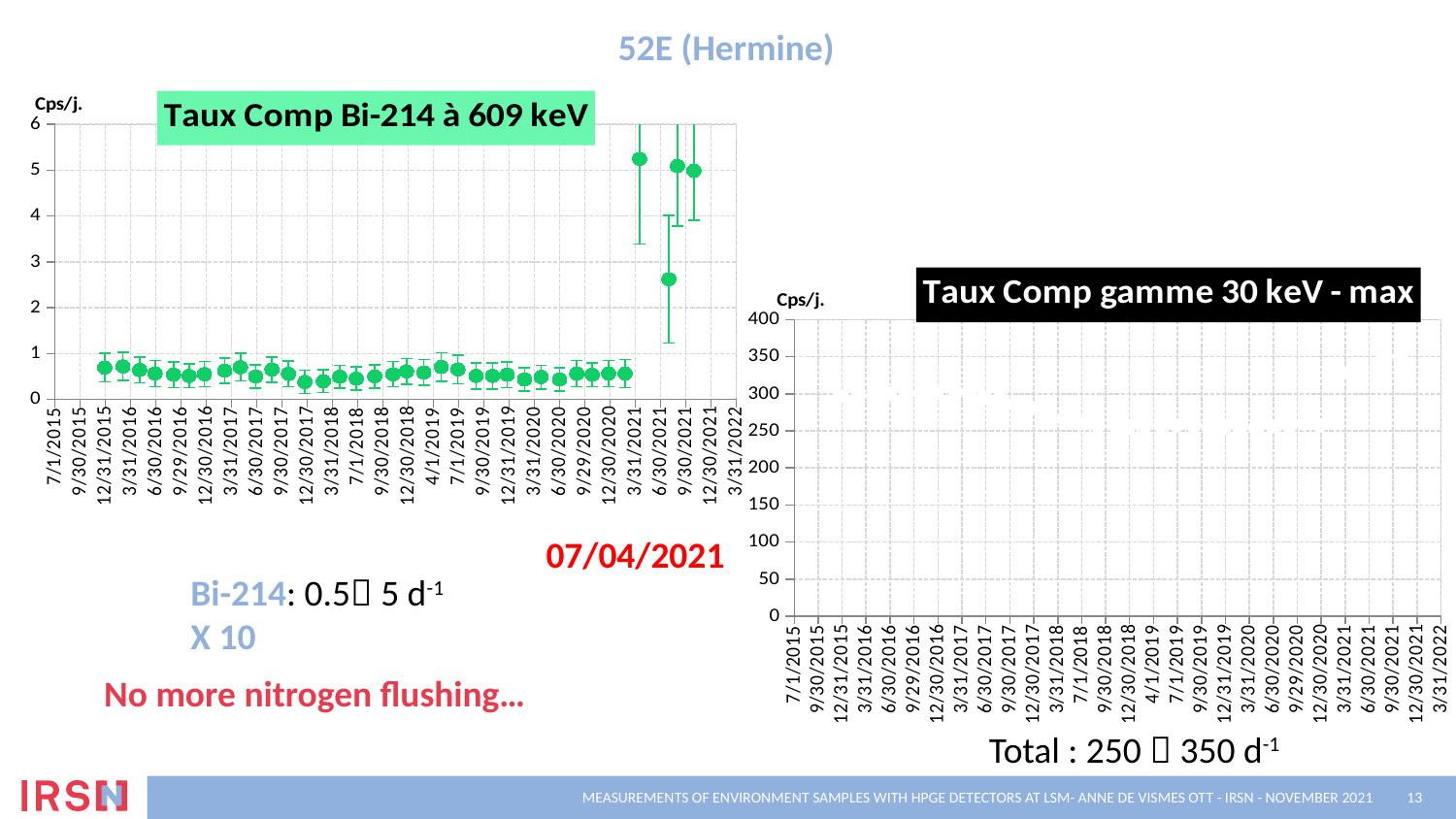
What kind of chart is the chart titled 'Taux Comp Bi-214 à 609 keV'? scatter chart with error bars In the chart titled 'Taux Comp Bi-214 à 609 keV', is the value for 6/30/2021 greater or less than 2? greater In the chart titled 'Taux Comp Bi-214 à 609 keV', is the value for 7/1/2018 greater or less than 2? less What is the title of the chart on the right of the slide? Taux Comp gamme 30 keV - max In the chart titled 'Taux Comp Bi-214 à 609 keV', is the value for 9/30/2021 greater or less than 3? greater In the chart titled 'Taux Comp Bi-214 à 609 keV', do the values rise or fall sharply at the 2021 end of the x axis? rise What is the title of the chart on the left of the slide? Taux Comp Bi-214 à 609 keV What is the highest value shown on the y axis of the chart titled 'Taux Comp gamme 30 keV - max'? 400 In the chart titled 'Taux Comp Bi-214 à 609 keV', which is larger, the value for 3/31/2021 or the value for 6/30/2021? 3/31/2021